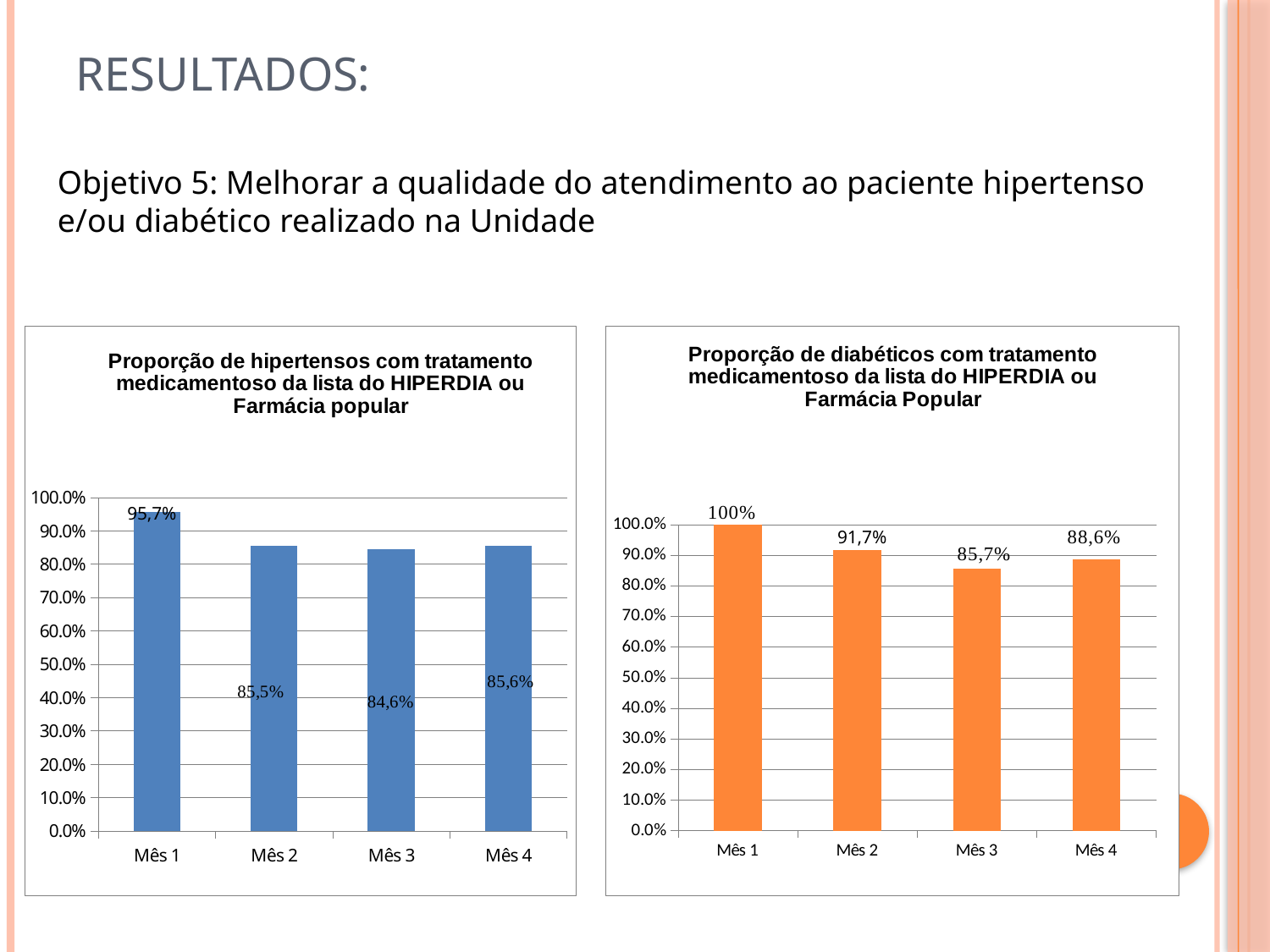
In the left chart (Proporção de hipertensos), which month has the highest value? Mês 1 What colour are the bars in the right chart (Proporção de diabéticos)? Orange In the right chart (Proporção de diabéticos), what is the value for Mês 4? 88,6% In the right chart (Proporção de diabéticos), what is the value for Mês 2? 91,7% In the left chart (Proporção de hipertensos), what is the difference between the values for Mês 1 and Mês 3? 11,1% What kind of chart is the right chart (Proporção de diabéticos)? Bar chart How many months are shown on the x axis of the left chart (Proporção de hipertensos)? 4 In the right chart (Proporção de diabéticos), which is larger, the value for Mês 2 or the value for Mês 3? Mês 2 In the left chart (Proporção de hipertensos), what is the value for Mês 1? 95,7% In the left chart (Proporção de hipertensos), what is the value for Mês 3? 84,6% In the right chart (Proporção de diabéticos), what is the difference between the values for Mês 1 and Mês 2? 8,3% In the right chart (Proporção de diabéticos), which month has the lowest value? Mês 3